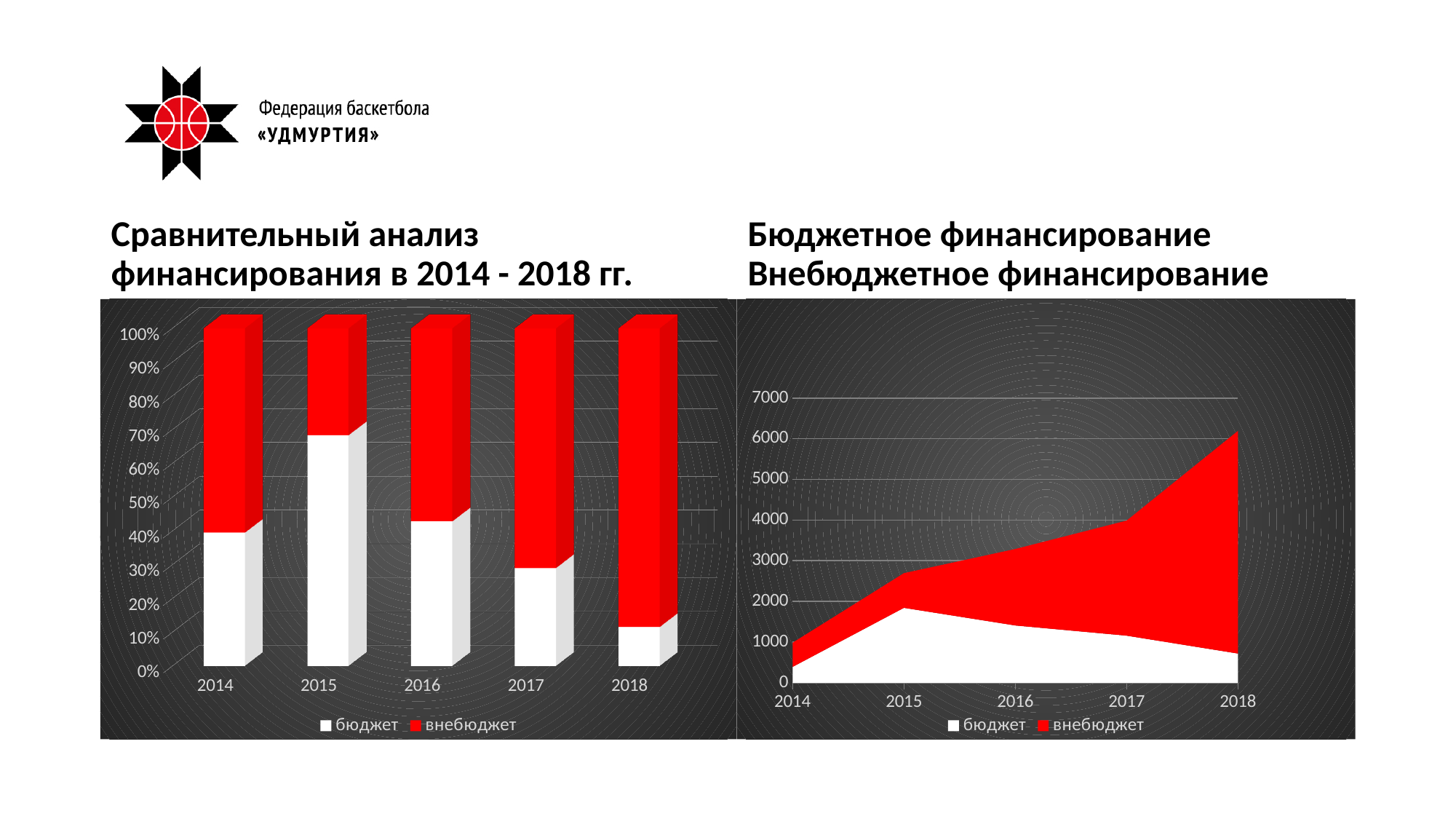
What kind of chart is the right chart titled "Бюджетное финансирование Внебюджетное финансирование"? area chart In the right chart, is the total (бюджет plus внебюджет) for 2018 greater or less than 5000? greater In the left chart, which year has the highest share for бюджет? 2015 In the left chart, which is larger in 2017: the бюджет share or the внебюджет share? внебюджет In the right chart, does the total funding rise or fall from 2014 to 2018? rises In the left chart, is the бюджет share for 2015 greater or less than 60%? greater What kind of chart is the left chart titled "Сравнительный анализ финансирования в 2014 - 2018 гг."? bar chart In the right chart, which colour represents внебюджет? red In the left chart, how many years are shown on the x axis? 5 In the right chart, how many series does the legend list? 2 In the left chart, which year has the lowest share for бюджет? 2018 In the left chart, is the бюджет share for 2018 greater or less than 20%? less